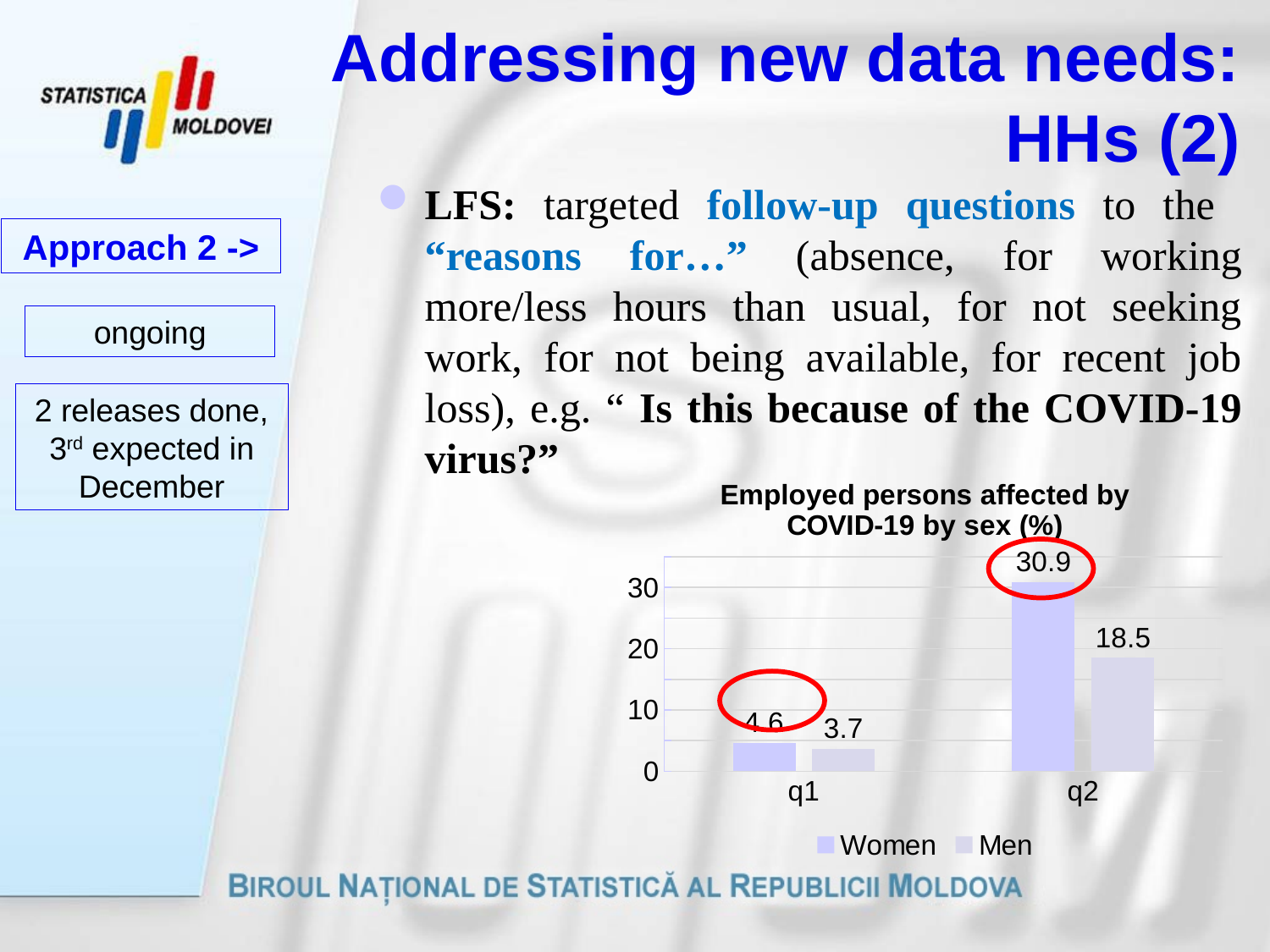
Which bar has the lowest value in the chart? Men in q1 How many categories are shown on the x axis of the chart? 2 Is the value for Women in q2 greater or less than 30? greater What type of chart is shown on the slide? bar chart Which bar has the highest value in the chart? Women in q2 Which series are listed in the chart legend? Women, Men What is the difference between the Women and Men values in q2? 12.4 What is the title of the chart? Employed persons affected by COVID-19 by sex (%) How many series does the chart legend list? 2 What is the value for Men in q2? 18.5 What is the value for Men in q1? 3.7 What is the value for Women in q2? 30.9